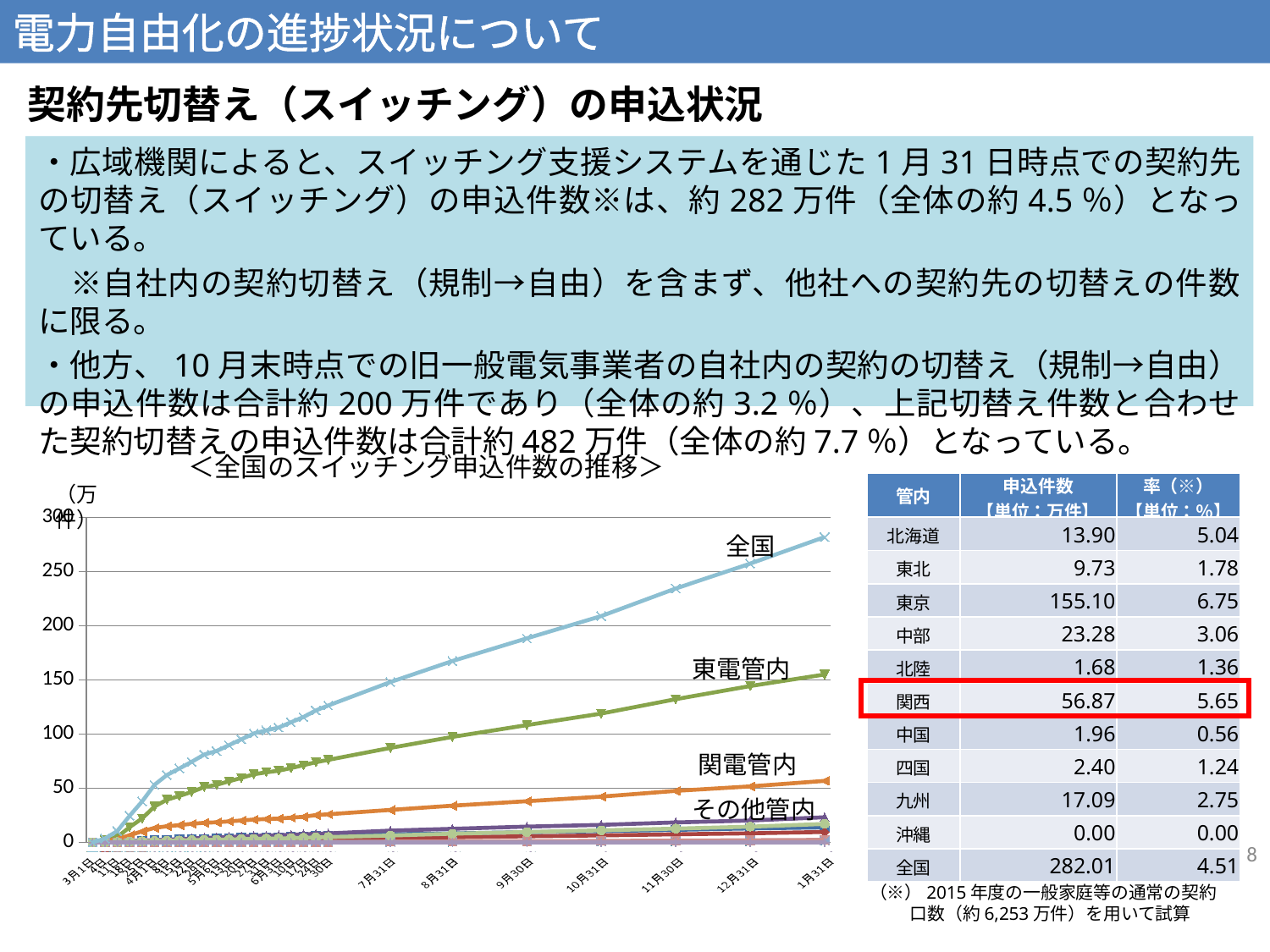
At 1月31日, which is larger, 関電管内 or その他管内? 関電管内 What kind of chart is shown on the slide? line chart Is the value for 東電管内 at 1月31日 greater or less than 100? greater Is the value for 全国 at 1月31日 greater or less than 250? greater Which labeled series is highest at 1月31日? 全国 At 1月31日, which is larger, 東電管内 or 関電管内? 東電管内 Is the value for 関電管内 at 1月31日 greater or less than 100? less Does the 全国 line rise or fall from 3月1日 to 1月31日? rise What unit is shown on the vertical axis of the chart? 万件 What is the title of the chart? ＜全国のスイッチング申込件数の推移＞